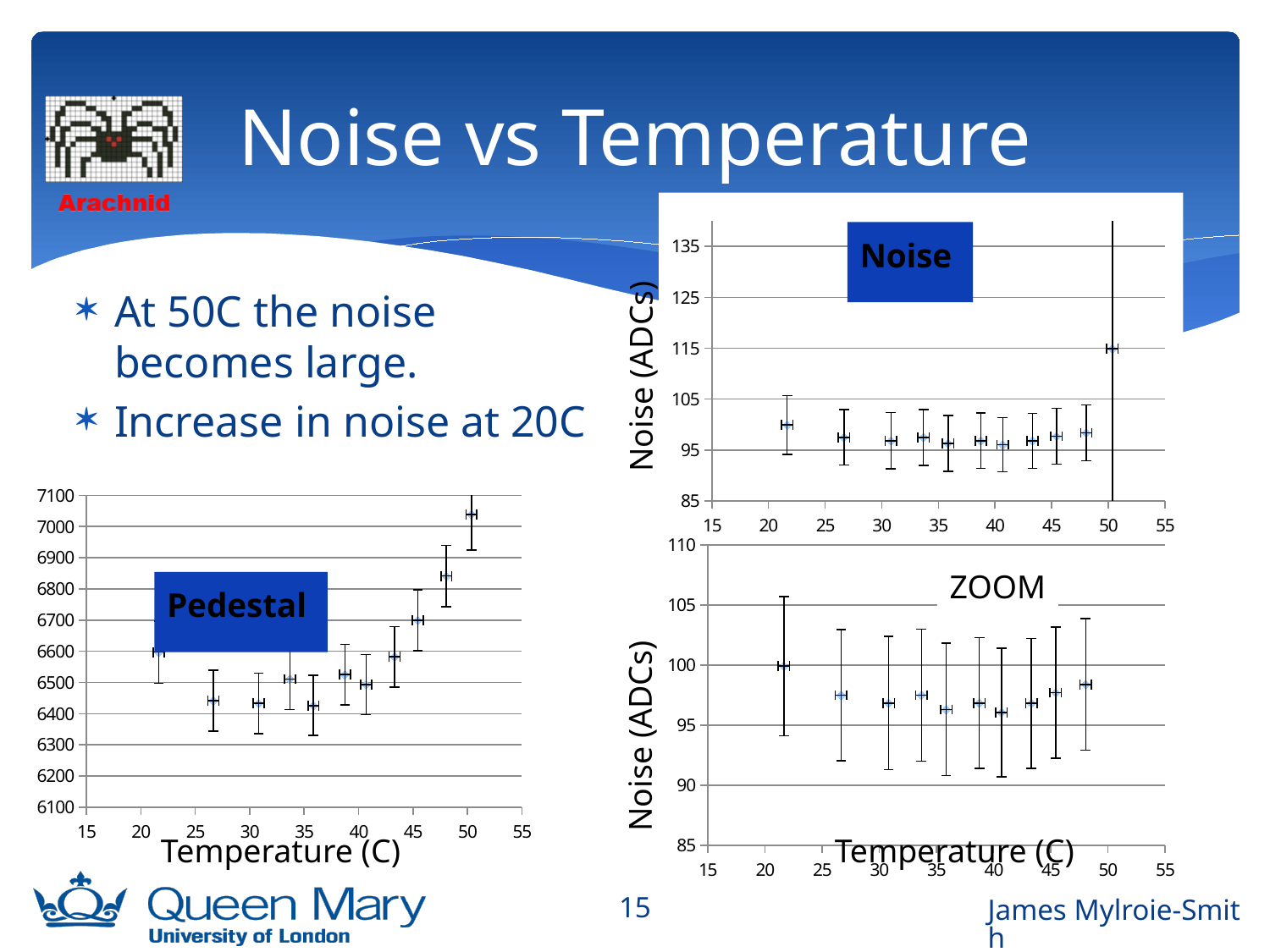
In the Pedestal chart, is the value at about 20C greater or less than 6500? greater In the Pedestal chart, is the value at about 50C greater or less than 7000? greater What kind of chart is the Noise chart? scatter chart In the Pedestal chart, is the value at about 30C greater or less than 6500? less What is the y-axis label of the Noise chart? Noise (ADCs) In the Pedestal chart, do the values rise or fall as temperature increases from 35 to 50? rise How many data points are plotted in the ZOOM chart? 10 How many data points are plotted in the Pedestal chart? 11